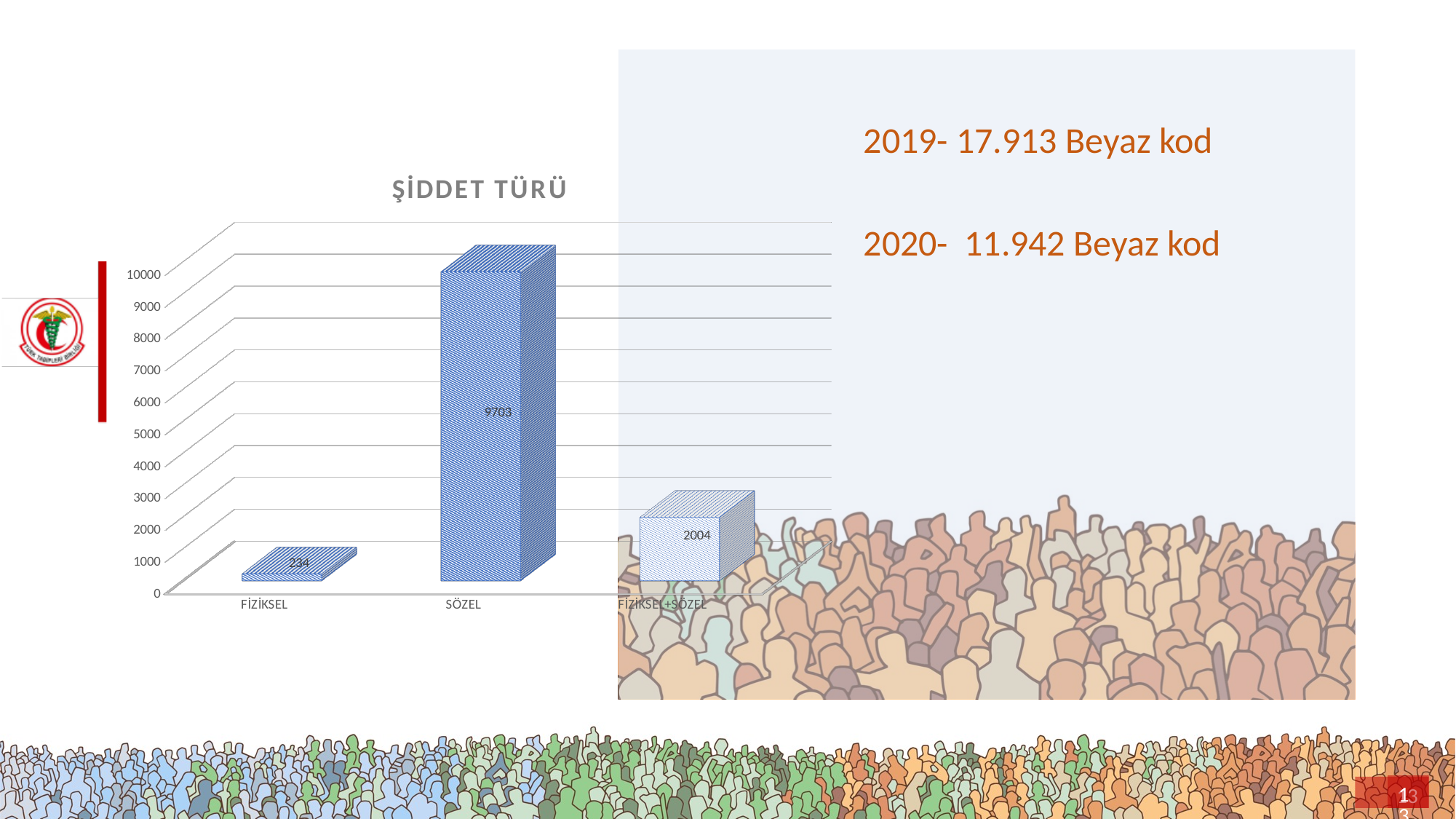
Is the value for SÖZEL in the ŞİDDET TÜRÜ chart greater or less than 9000? greater Which is larger in the ŞİDDET TÜRÜ chart, FİZİKSEL or FİZİKSEL+SÖZEL? FİZİKSEL+SÖZEL What is the value for FİZİKSEL+SÖZEL in the ŞİDDET TÜRÜ chart? 2004 What is the value for SÖZEL in the ŞİDDET TÜRÜ chart? 9703 What kind of chart is the ŞİDDET TÜRÜ chart? bar chart What is the difference between the FİZİKSEL+SÖZEL and FİZİKSEL values in the ŞİDDET TÜRÜ chart? 1770 What is the title of the chart on the slide? ŞİDDET TÜRÜ Which category has the lowest value in the ŞİDDET TÜRÜ chart? FİZİKSEL How many categories are shown in the ŞİDDET TÜRÜ chart? 3 What is the difference between the SÖZEL and FİZİKSEL+SÖZEL values in the ŞİDDET TÜRÜ chart? 7699 Which category has the highest value in the ŞİDDET TÜRÜ chart? SÖZEL What is the value for FİZİKSEL in the ŞİDDET TÜRÜ chart? 234